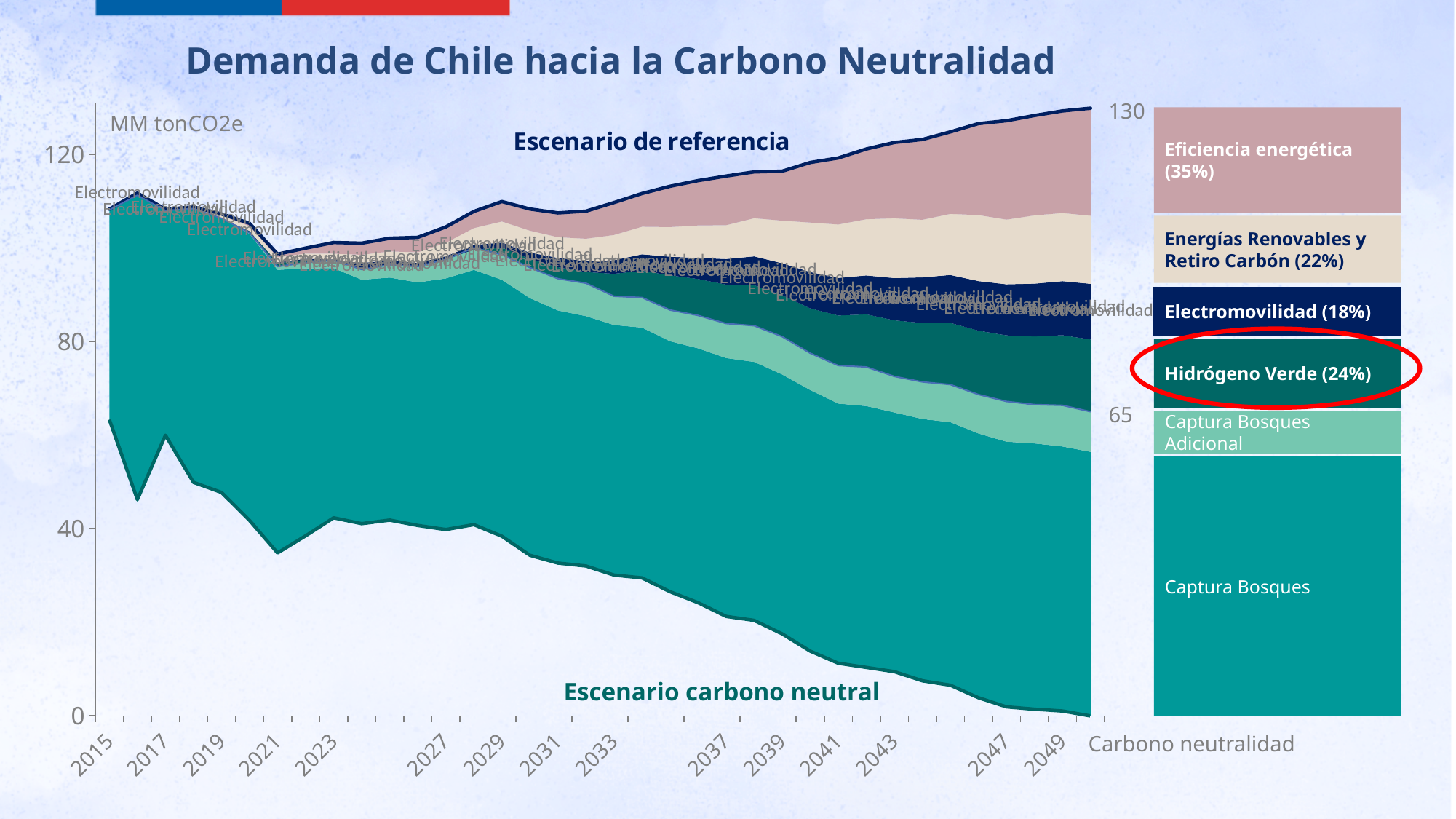
What percentage is shown for Energías Renovables y Retiro Carbón? 22% What kind of chart is the main chart on the slide? Area chart Which legend entry has the highest percentage? Eficiencia energética (35%) Does the Escenario carbono neutral line rise or fall from 2015 to 2049? Falls Which has a larger percentage, Eficiencia energética or Electromovilidad? Eficiencia energética Is the Escenario carbono neutral value in 2049 greater or less than 40? less Which legend entry is circled in red? Hidrógeno Verde (24%) What percentage is shown for Eficiencia energética in the legend? 35% Is the Escenario de referencia value in 2049 greater or less than 120? greater How many entries does the legend on the right list? 6 What is the difference between the percentages for Eficiencia energética and Electromovilidad? 17 percentage points What percentage is shown for Hidrógeno Verde in the legend? 24%